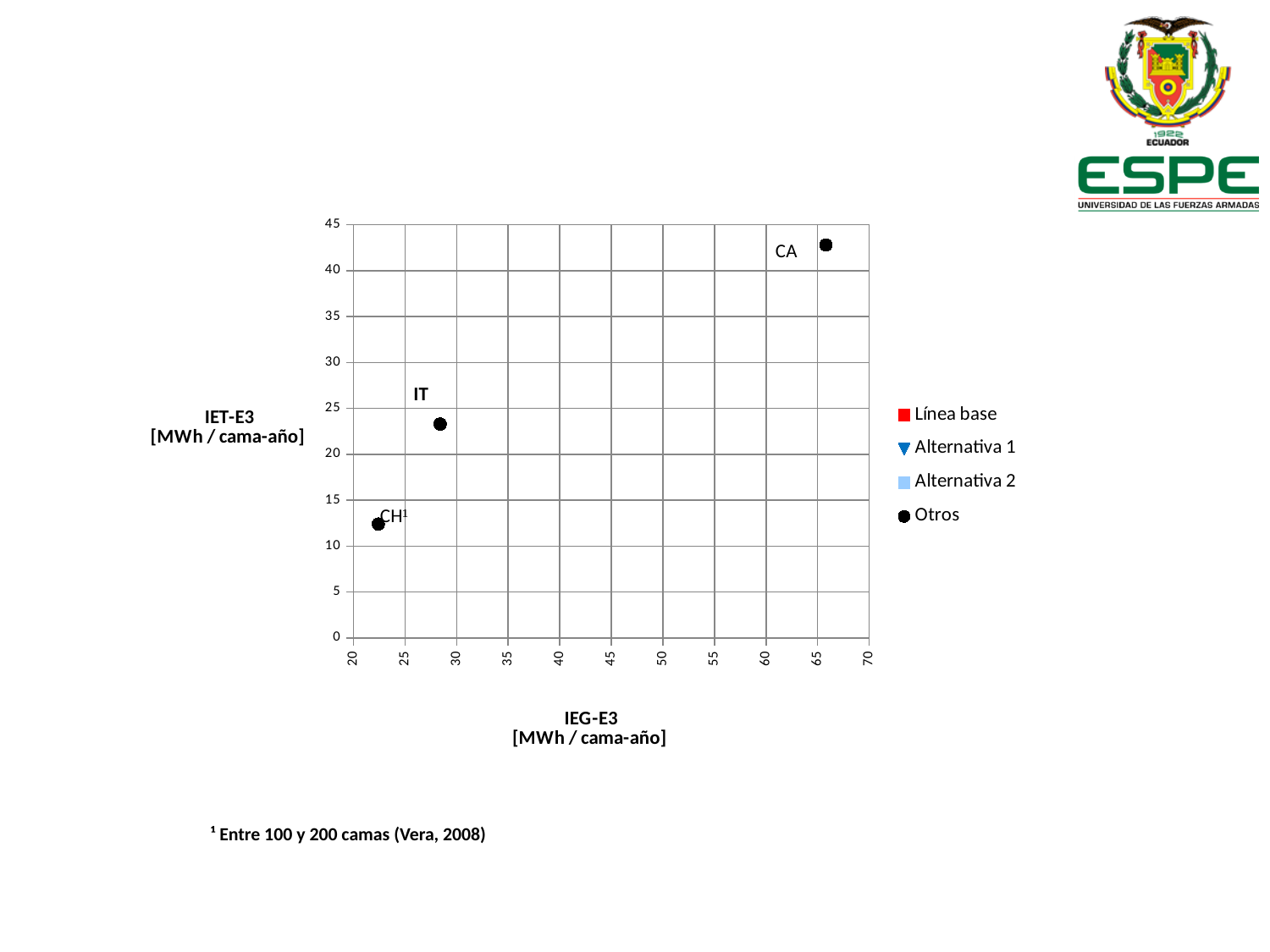
How many labeled data points are plotted on the chart? 3 What is the label of the x axis? IEG-E3 [MWh / cama-año] Is the IEG-E3 value for CH greater or less than 25? less What kind of chart is shown on the slide? scatter chart How many series does the legend list? 4 Which labeled point has the highest IEG-E3 value? CA Is the IET-E3 value for CA greater or less than 40? greater Which labeled point has the lowest IET-E3 value? CH Which labeled point has the highest IET-E3 value? CA Which labeled point has the lowest IEG-E3 value? CH Which has a higher IET-E3 value, IT or CH? IT Is the IET-E3 value for IT greater or less than 25? less